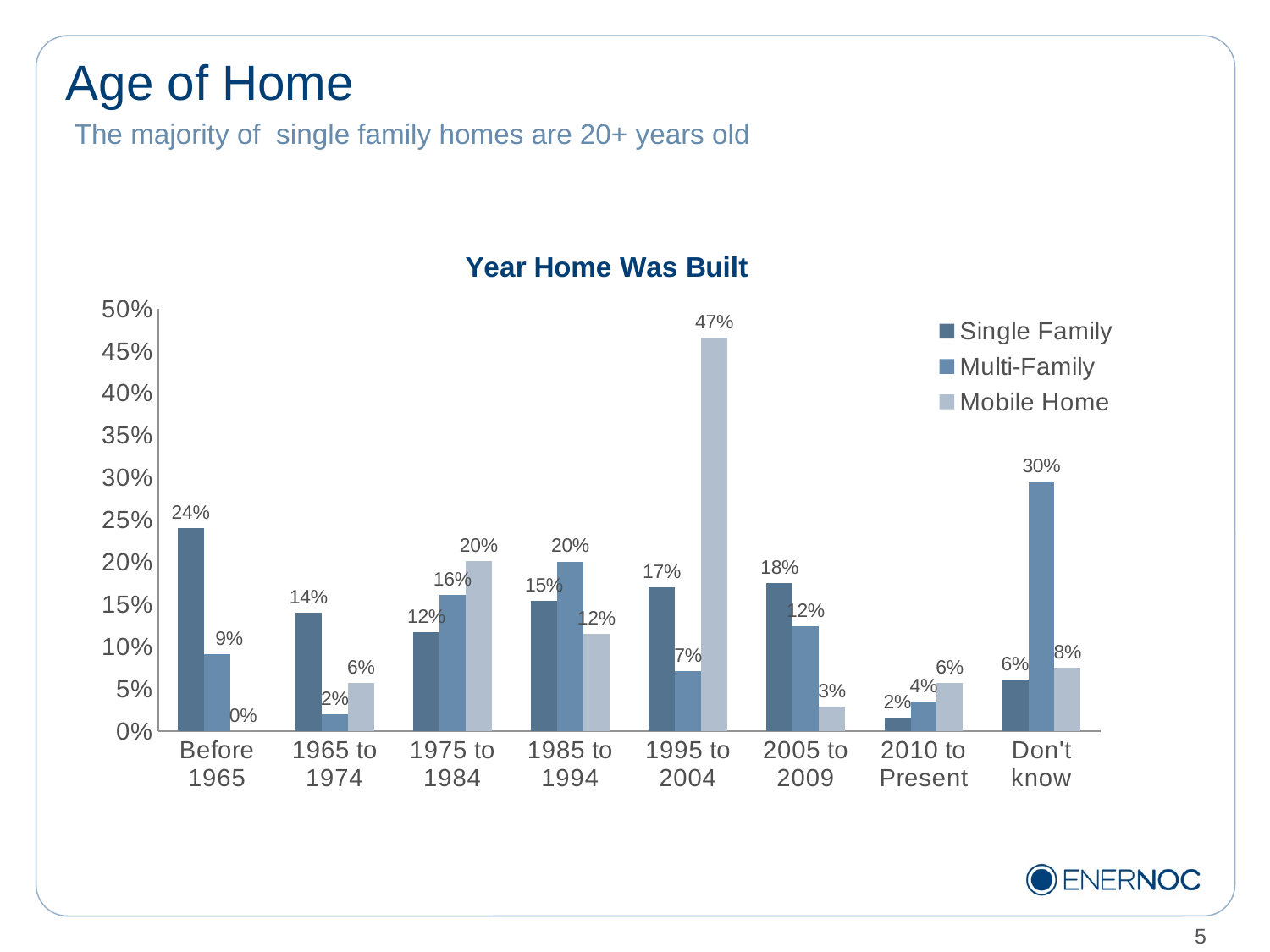
What is the Mobile Home value for 1995 to 2004? 47% What is the Mobile Home value for Before 1965? 0% How many series does the legend list? 3 What is the difference between the Mobile Home value and the Single Family value for 1995 to 2004? 30% What is the Single Family value for Before 1965? 24% What kind of chart is shown? Bar chart How many year categories are shown on the x axis? 8 Which category has the highest Single Family value? Before 1965 Which category has the lowest Single Family value? 2010 to Present What is the Multi-Family value for Don't know? 30% What is the title of the chart? Year Home Was Built For 1985 to 1994, which is larger: the Multi-Family value or the Single Family value? Multi-Family